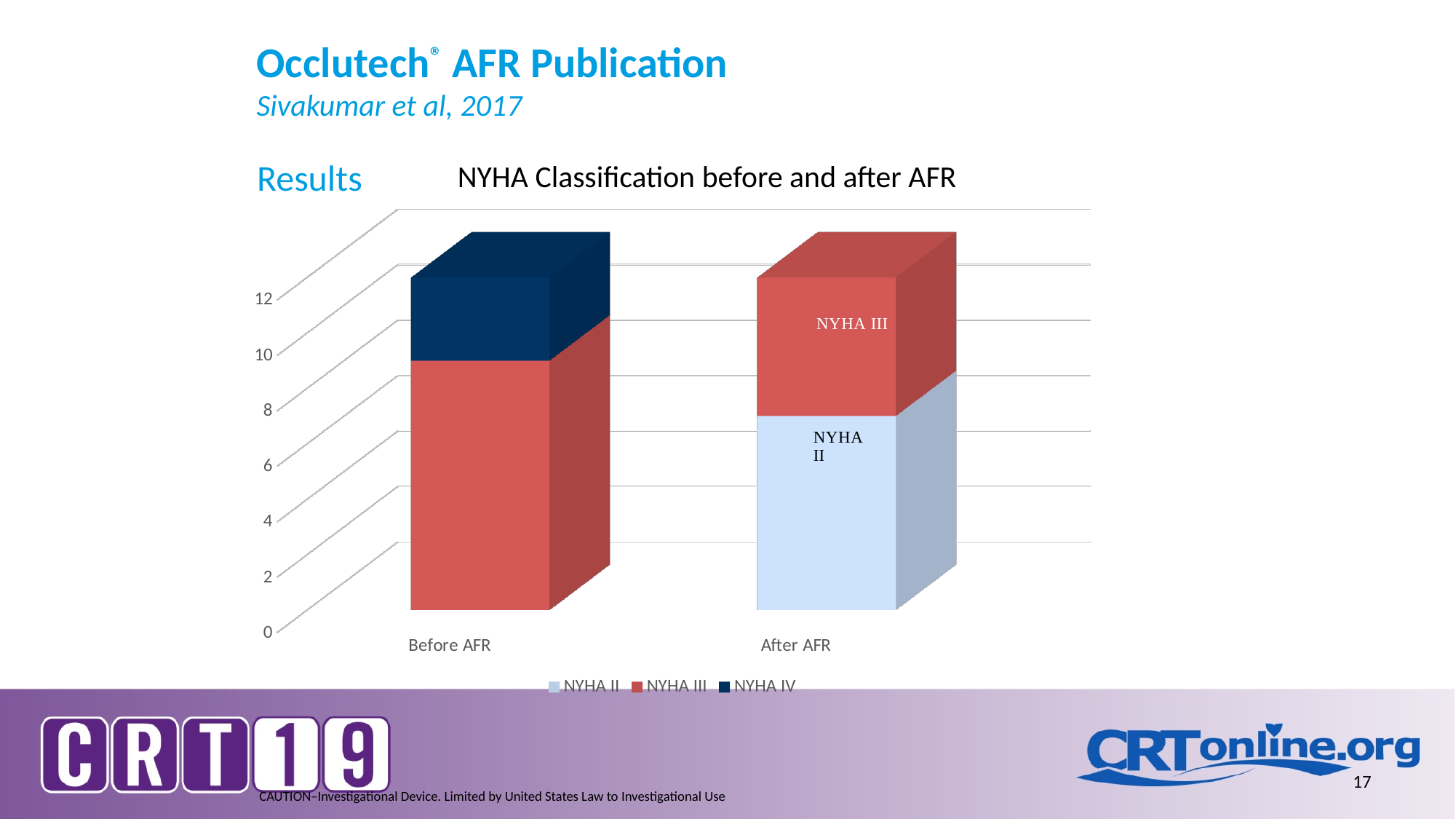
Is the value for NYHA III in the After AFR bar greater or less than 8? less How many series does the chart legend list? 3 Is the value for NYHA IV in the Before AFR bar greater or less than 6? less Is the value for NYHA II in the After AFR bar greater or less than 4? greater Which category has the larger NYHA III value, Before AFR or After AFR? Before AFR What kind of chart is shown on the slide? Stacked bar chart Which category is the only one with an NYHA II segment? After AFR What is the title of the chart? NYHA Classification before and after AFR In the After AFR bar, which segment is larger, NYHA II or NYHA III? NYHA II Which series from the legend does not appear in the After AFR bar? NYHA IV How many categories are shown on the x axis of the chart? 2